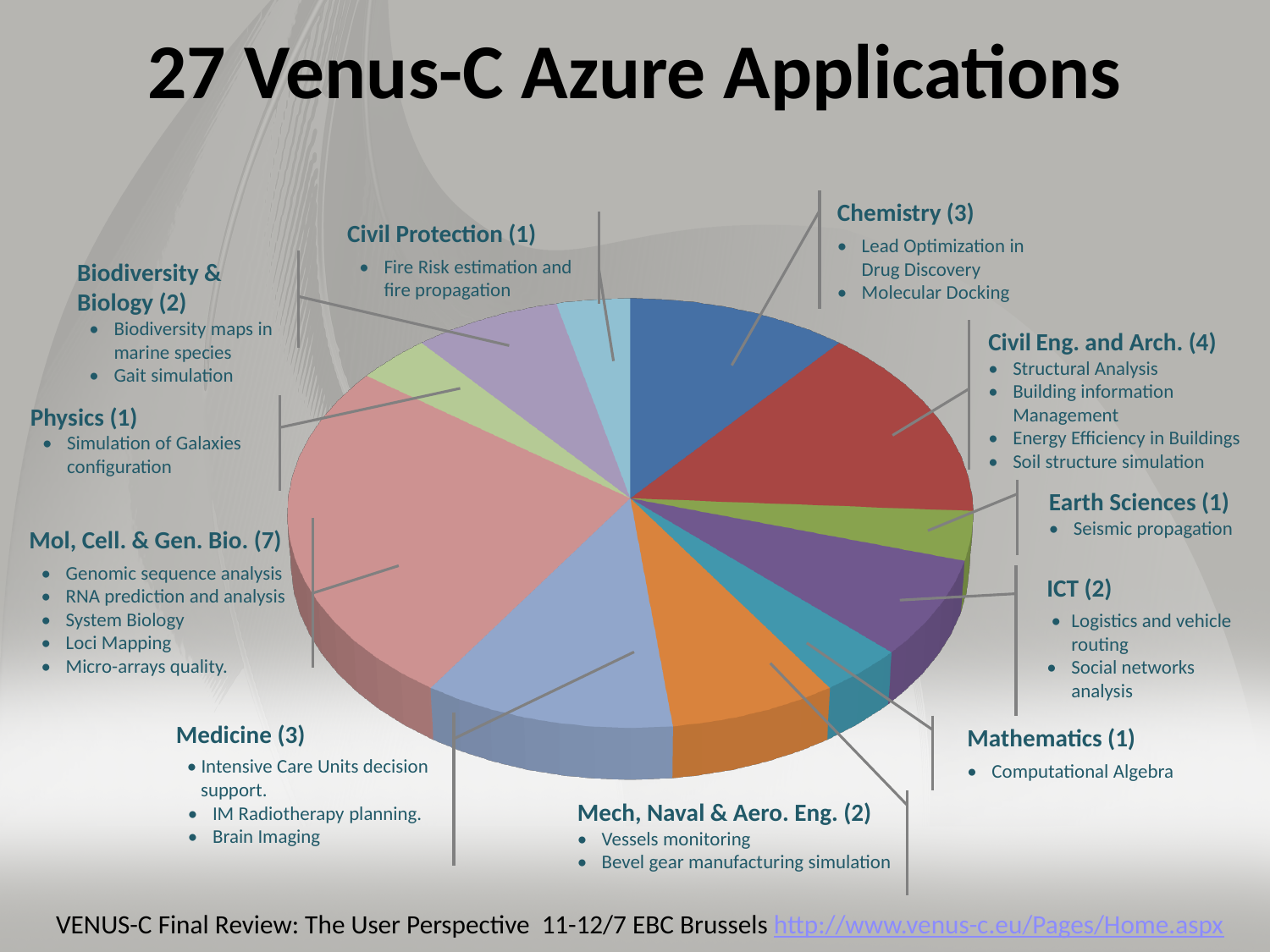
How many applications are listed for Chemistry? 3 How many categories (slices) does the pie chart have? 11 Which category has the largest slice of the pie? Mol, Cell. & Gen. Bio. Which has more applications, Civil Eng. and Arch. or Chemistry? Civil Eng. and Arch. What is the difference between the number of applications for Mol, Cell. & Gen. Bio. and for Civil Eng. and Arch.? 3 How many applications does the chart attribute to Mol, Cell. & Gen. Bio.? 7 What is the title of the slide containing the pie chart? 27 Venus-C Azure Applications How many applications are listed for Civil Eng. and Arch.? 4 How many applications are listed for ICT? 2 Which has more applications, Medicine or Mathematics? Medicine What is the total number of applications across all slices of the pie? 27 What kind of chart is shown on the slide? pie chart